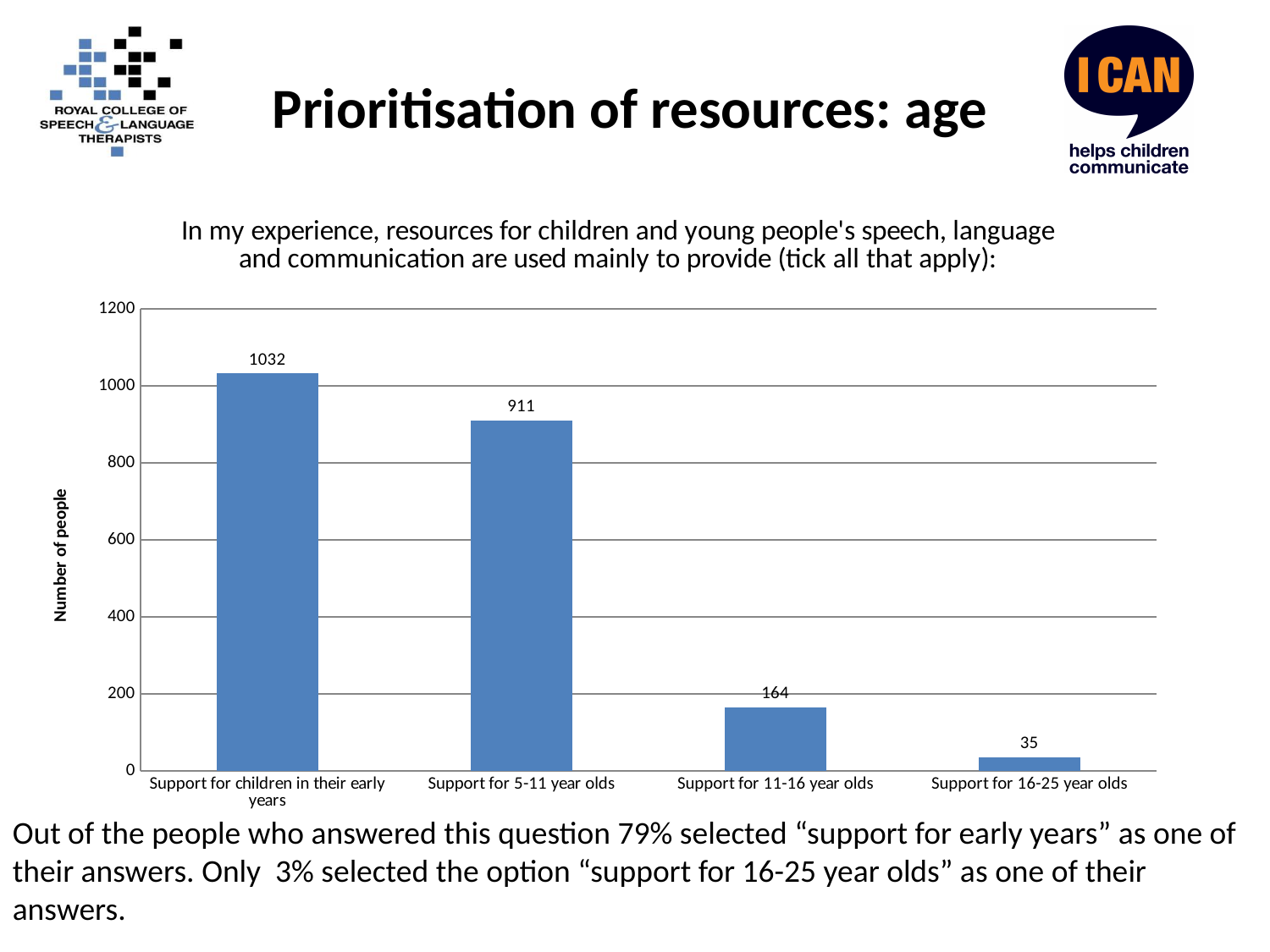
How many categories are shown on the x axis? 4 What is the label of the y axis? Number of people How many people selected 'Support for children in their early years'? 1032 What is the difference between the values for 'Support for children in their early years' and 'Support for 5-11 year olds'? 121 What is the difference between the values for 'Support for 11-16 year olds' and 'Support for 16-25 year olds'? 129 What is the value for 'Support for 16-25 year olds'? 35 What is the value for 'Support for 11-16 year olds'? 164 Which is larger: the value for 'Support for 5-11 year olds' or 'Support for 11-16 year olds'? Support for 5-11 year olds What kind of chart is shown on the slide? Bar chart Which category has the highest number of people? Support for children in their early years Which category has the lowest number of people? Support for 16-25 year olds What is the value for 'Support for 5-11 year olds'? 911